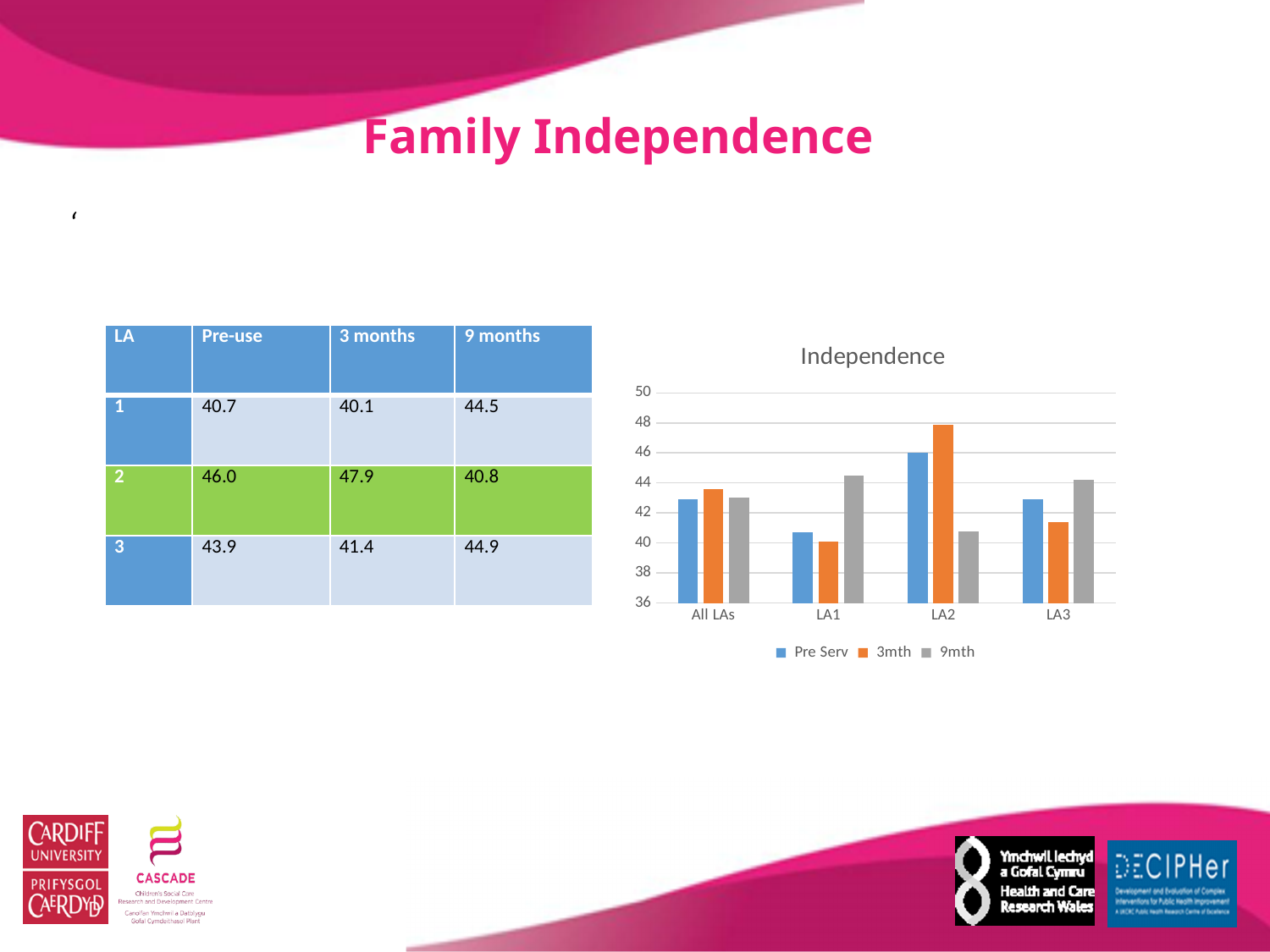
How many series does the chart legend list? 3 What kind of chart is shown on the slide? bar chart Is the Pre Serv value for All LAs greater or less than 42? greater How many categories are shown on the x axis of the chart? 4 Is the 9mth value for LA1 greater or less than 44? greater Is the 3mth value for LA3 greater or less than 42? less Which category has the lowest 9mth value in the chart? LA2 Is the Pre Serv value for LA2 larger or smaller than the Pre Serv value for LA1? larger Which category has the highest 3mth value in the chart? LA2 What is the title of the chart? Independence Which series is shown in orange in the chart? 3mth